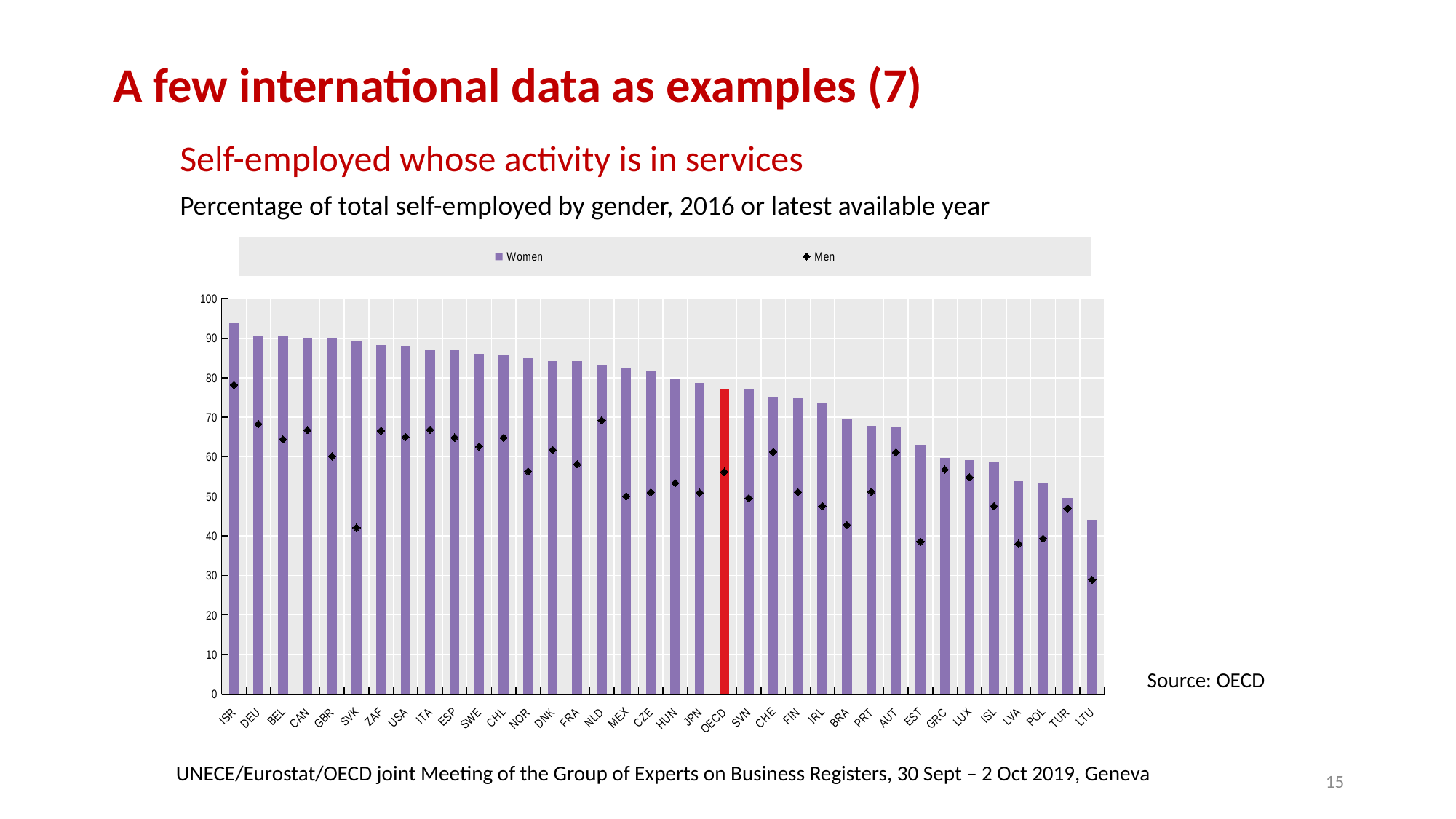
Which country has the lowest value for Men? LTU How many series does the legend list? 2 Which country has the lowest share of self-employed women in services? LTU Which country has the highest share of self-employed women in services? ISR Do the Women values rise or fall moving from left to right along the x axis? fall Which is larger, the Men value for ZAF or the Men value for SVK? ZAF Is the Women value for ISR greater or less than 90? greater Is the Women value for OECD greater or less than 70? greater What kind of chart is shown on the slide? bar chart Is the Women value for LTU greater or less than 50? less How many countries or groups are shown on the x axis? 36